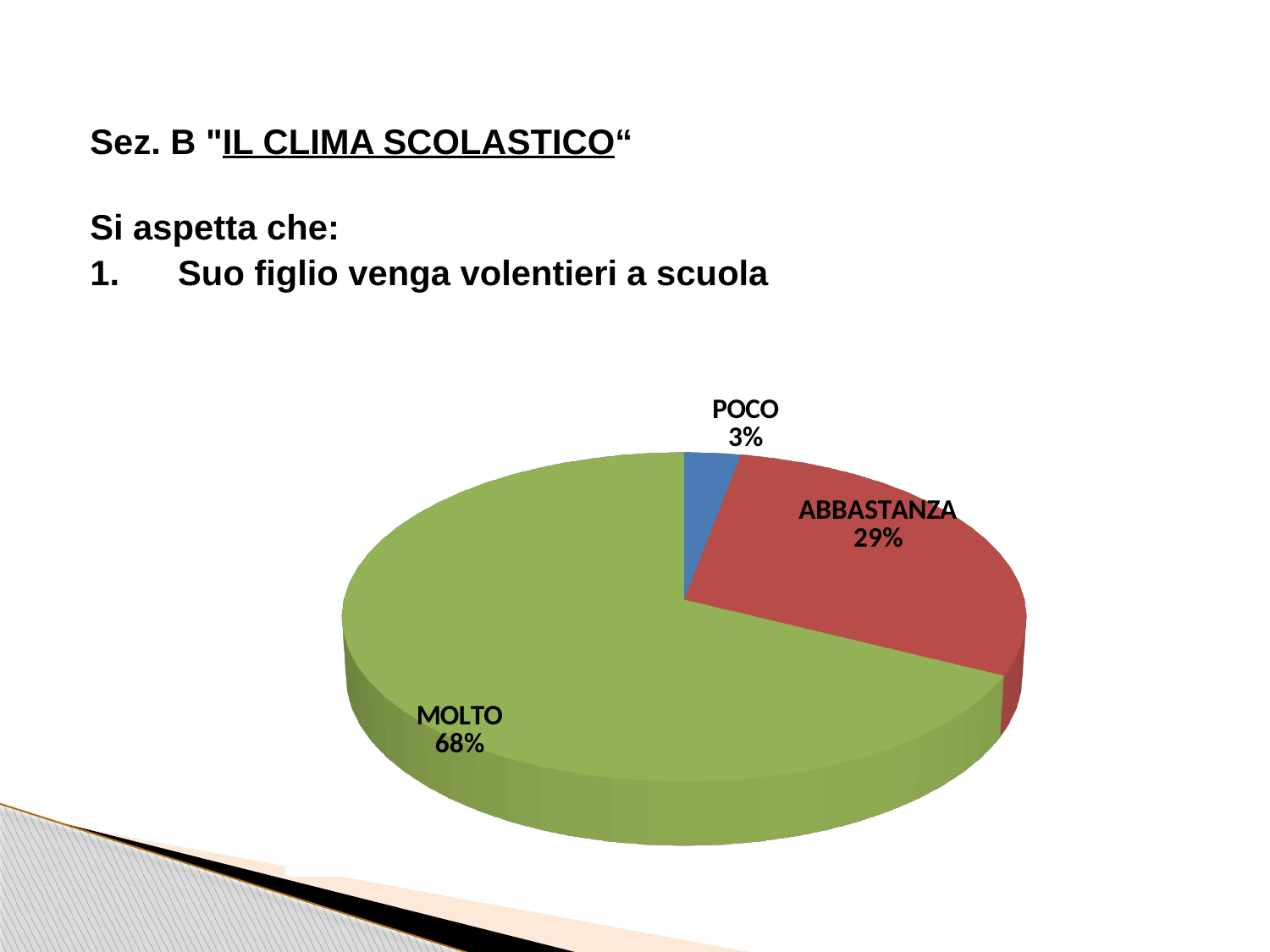
Which is larger, the share for ABBASTANZA or the share for POCO? ABBASTANZA What percentage of the pie is labelled ABBASTANZA? 29% What is the difference in percentage points between ABBASTANZA and POCO? 26 How many slices does the pie chart have? 3 Which category has the largest share of the pie? MOLTO Which category has the smallest share of the pie? POCO What colour is the POCO slice? blue What is the difference in percentage points between MOLTO and ABBASTANZA? 39 What kind of chart is shown on the slide? pie chart What percentage of the pie is labelled POCO? 3% What percentage of the pie is labelled MOLTO? 68% What colour is the MOLTO slice? green